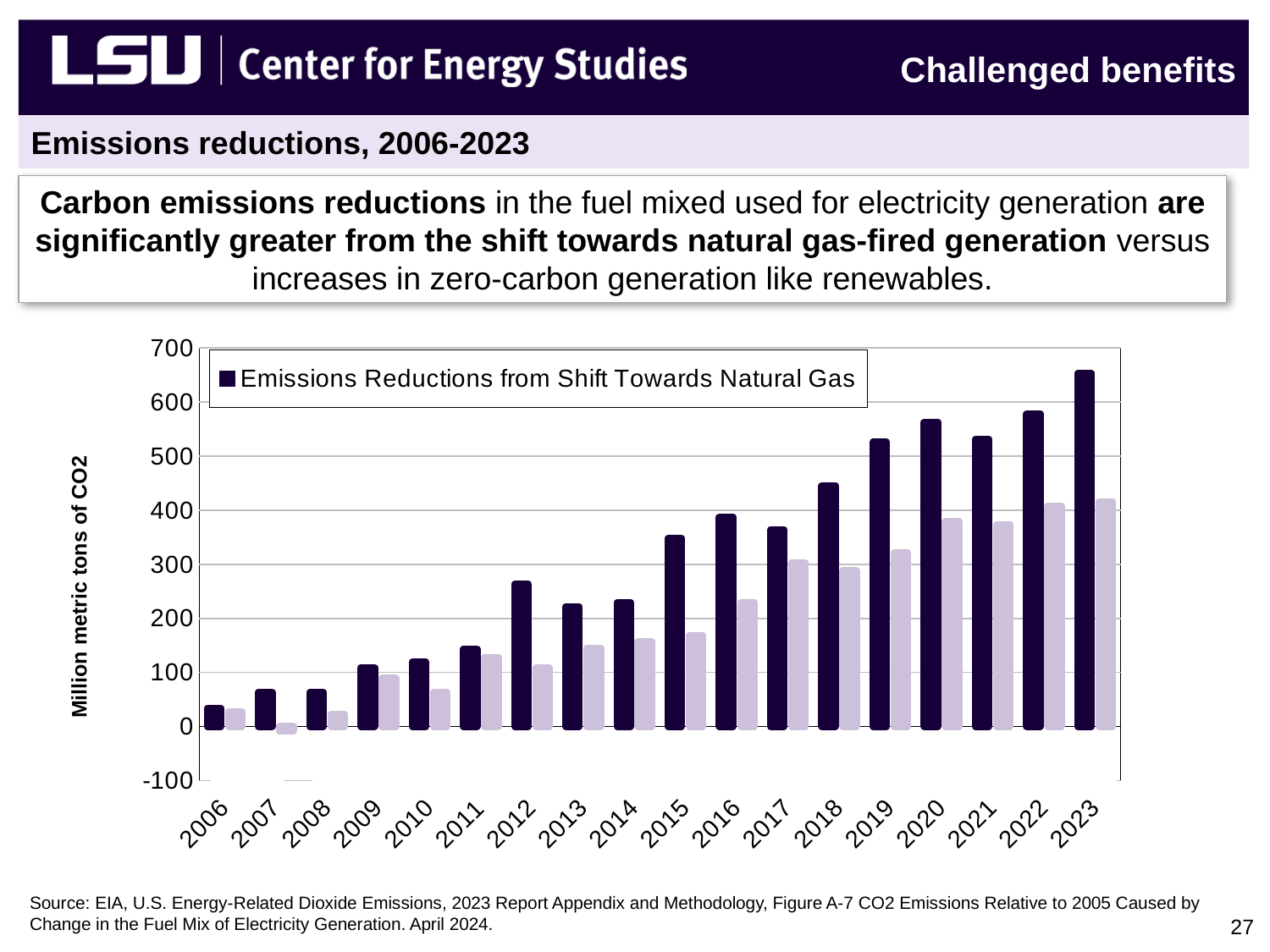
How many series does the chart's legend list? 1 Is the Emissions Reductions from Shift Towards Natural Gas value for 2023 greater or less than 600? greater Is the Emissions Reductions from Shift Towards Natural Gas value for 2019 greater or less than 500? greater Which year has the larger Emissions Reductions from Shift Towards Natural Gas value, 2015 or 2017? 2017 In which year is the Emissions Reductions from Shift Towards Natural Gas bar highest? 2023 What is the label on the vertical axis of the chart? Million metric tons of CO2 How many years are shown along the x axis of the chart? 18 In which year is the Emissions Reductions from Shift Towards Natural Gas bar lowest? 2006 What series name appears in the chart's legend? Emissions Reductions from Shift Towards Natural Gas Do the Emissions Reductions from Shift Towards Natural Gas values generally rise or fall from 2006 to 2023? Rise Is the Emissions Reductions from Shift Towards Natural Gas value for 2012 greater or less than 300? less What kind of chart is shown on the slide? Bar chart